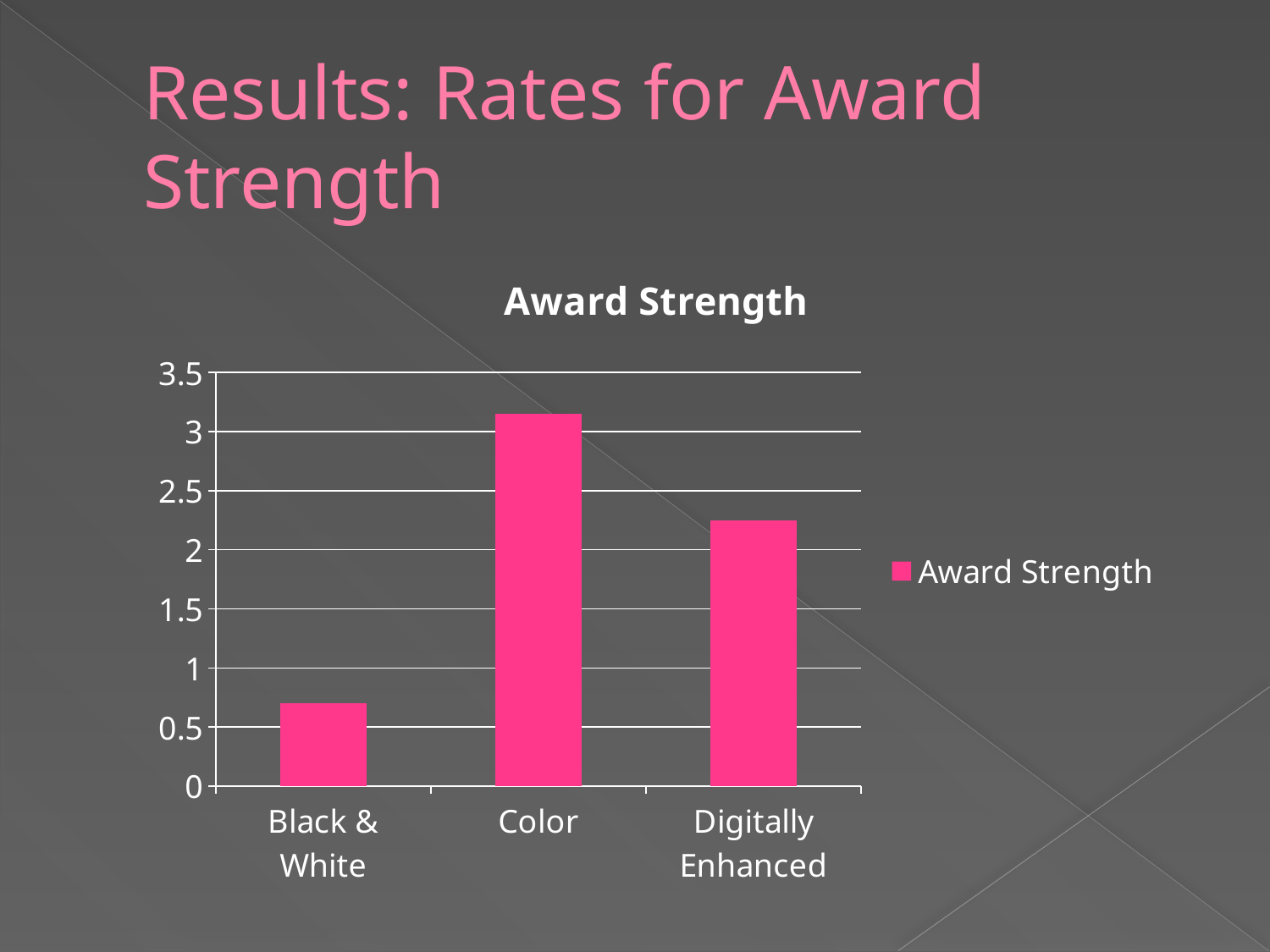
How many series does the legend list? 1 Is the value for Black & White greater or less than 1? less What type of chart is shown on the slide? bar chart What is the name of the series shown in the legend? Award Strength Which category has the lowest award strength? Black & White What is the title of the chart? Award Strength Which is larger, the value for Color or the value for Digitally Enhanced? Color Is the value for Color greater or less than 3? greater Is the value for Digitally Enhanced greater or less than 2.5? less How many categories are shown on the x axis? 3 Which category has the highest award strength? Color